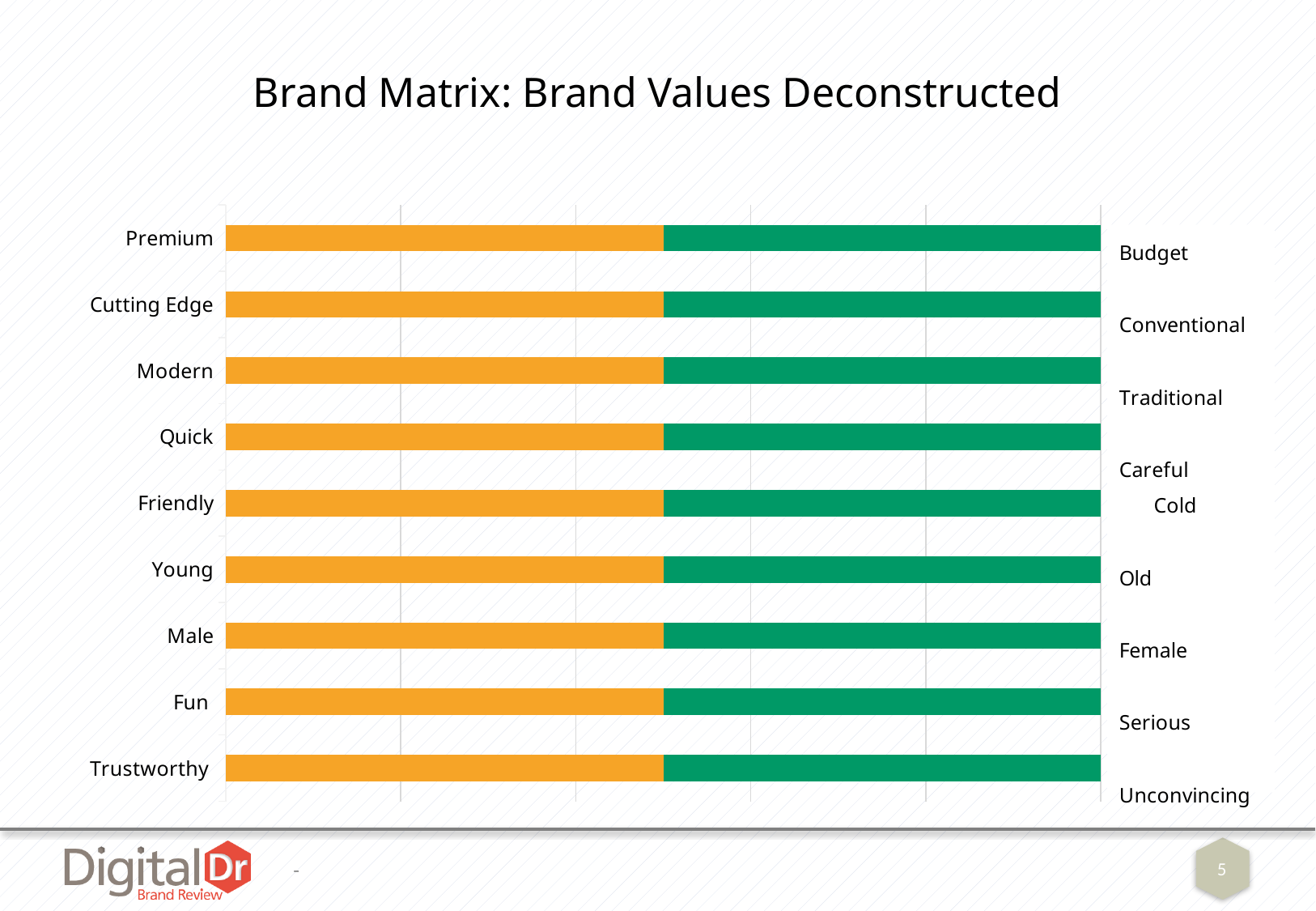
Which category label appears at the bottom of the chart's left axis? Trustworthy Which label on the right side of the chart is paired with 'Trustworthy'? Unconvincing Which category label appears at the top of the chart's left axis? Premium What colour is the left-hand segment of each bar in the chart? Orange Which label on the right side of the chart is paired with 'Male'? Female What is the title of the slide containing the chart? Brand Matrix: Brand Values Deconstructed How many categories (bars) are plotted in the chart? 9 Which label on the right side of the chart is paired with 'Premium'? Budget What kind of chart is shown on the slide? Bar chart